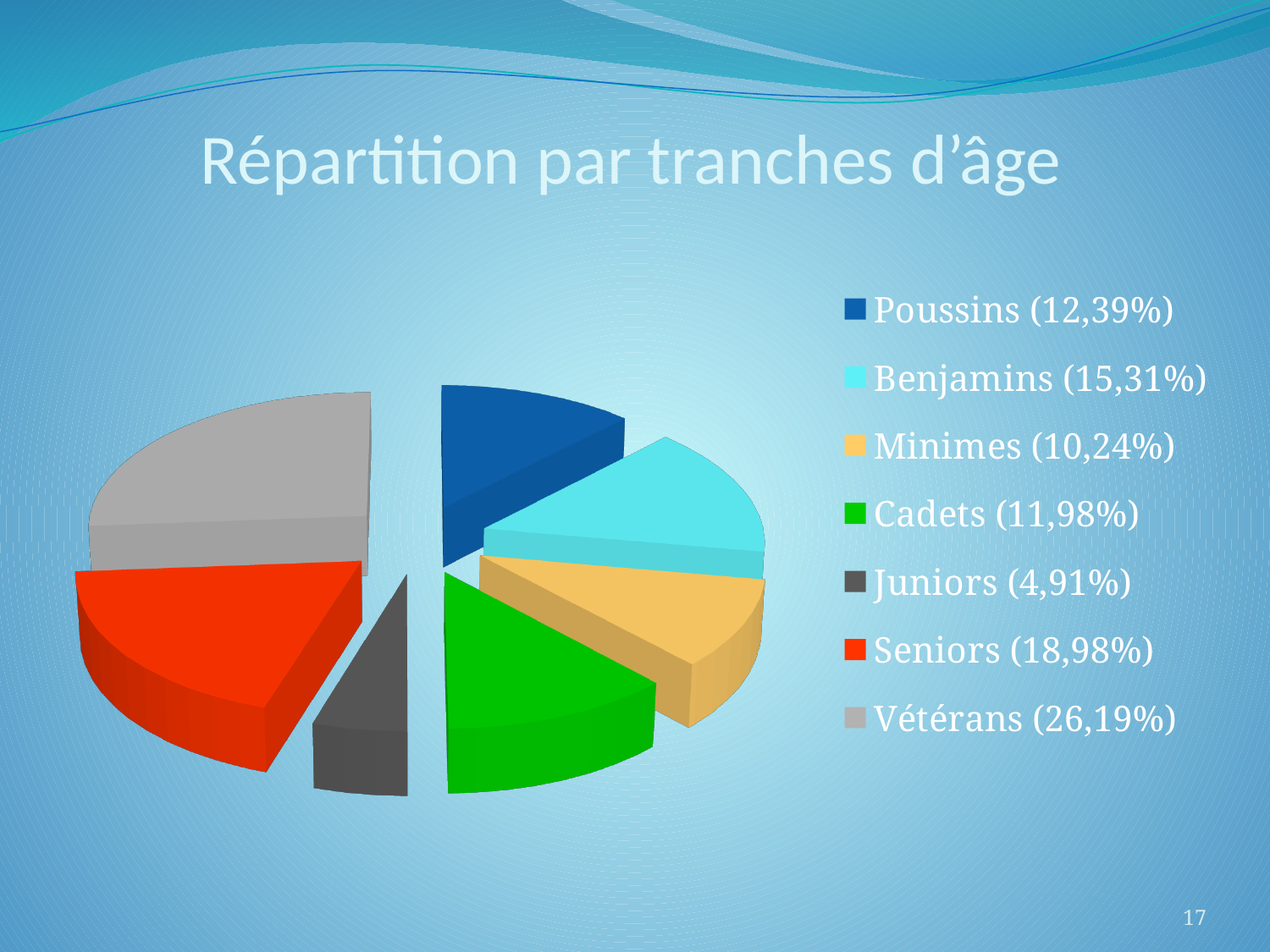
What is the difference between the shares of Cadets and Juniors? 7,07% Which colour represents Seniors in the pie chart? Red What is the value for Benjamins? 15,31% What is the title of the chart? Répartition par tranches d'âge What kind of chart is shown on the slide? Pie chart What is the difference between the shares of Vétérans and Seniors? 7,21% How many categories does the pie chart have? 7 What share of the pie is Vétérans? 26,19% Which category has the largest share? Vétérans Which category has the smallest share? Juniors What is the value for Juniors? 4,91% Which is larger, the share of Benjamins or the share of Minimes? Benjamins